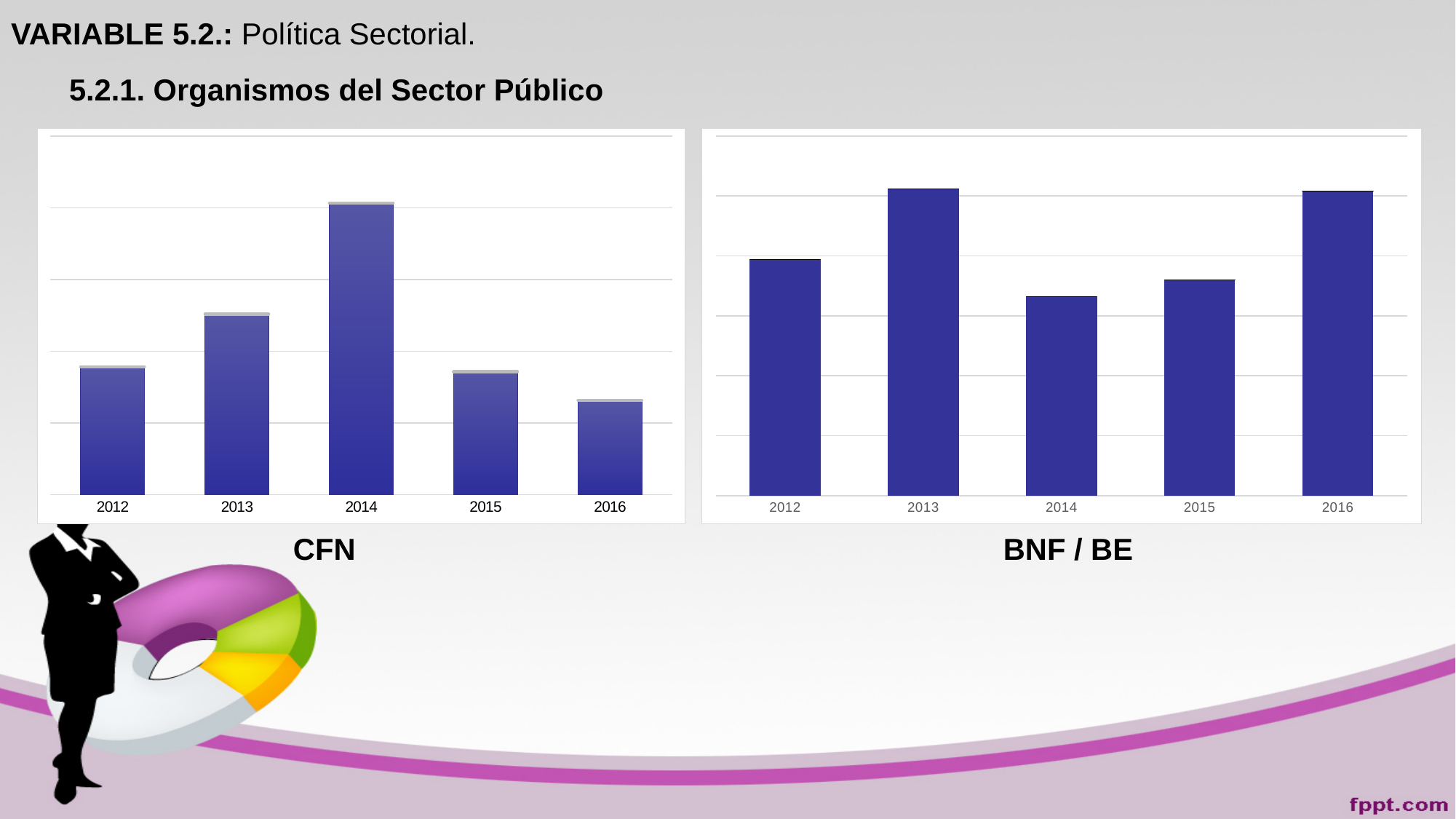
In the BNF / BE chart, do the values rise or fall from 2014 to 2016? rise In the CFN chart, how many years are shown on the x axis? 5 In the CFN chart, is the value for 2013 larger or smaller than the value for 2012? larger In the BNF / BE chart, is the value for 2012 larger or smaller than the value for 2015? larger In the BNF / BE chart, is the value for 2013 larger or smaller than the value for 2014? larger In the CFN chart, which year has the highest bar? 2014 What are the labels under the two charts on the slide? CFN and BNF / BE What kind of chart is the BNF / BE chart? bar chart In the CFN chart, which year has the lowest bar? 2016 In the BNF / BE chart, how many bars are plotted? 5 In the BNF / BE chart, which year has the lowest bar? 2014 In the CFN chart, do the values rise or fall from 2014 to 2016? fall